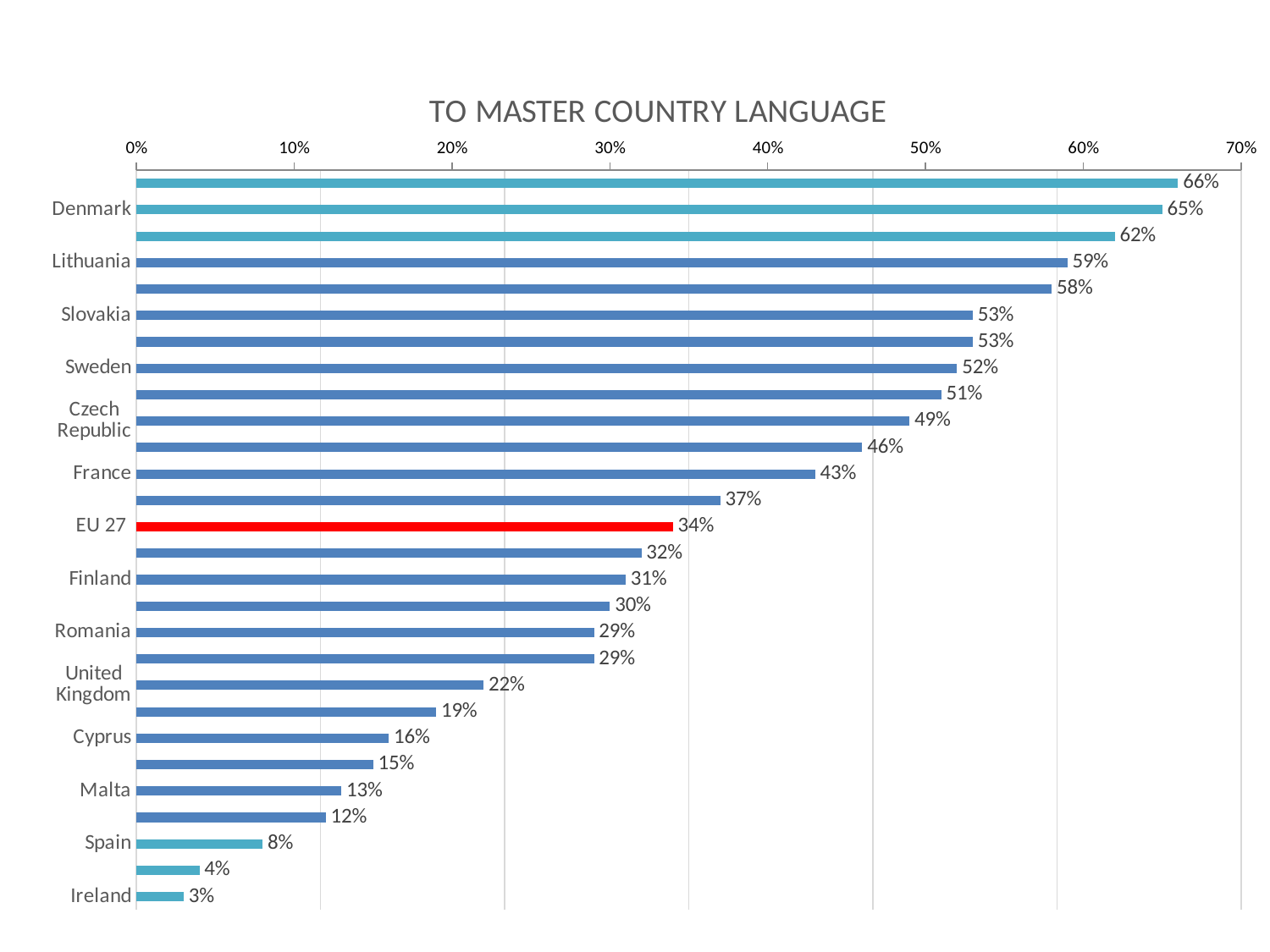
What kind of chart is shown? Bar chart What is the value for United Kingdom? 22% What is the value for France? 43% What is the value for Denmark? 65% What is the value for EU 27? 34% Which labelled country has the lowest value? Ireland What colour is the bar for EU 27? Red What is the difference between the values for Denmark and Ireland? 62 percentage points What is the value for Spain? 8% Is the value for Czech Republic greater or less than 40%? greater What is the highest value shown on the chart? 66% Which is larger, the value for Sweden or the value for Finland? Sweden